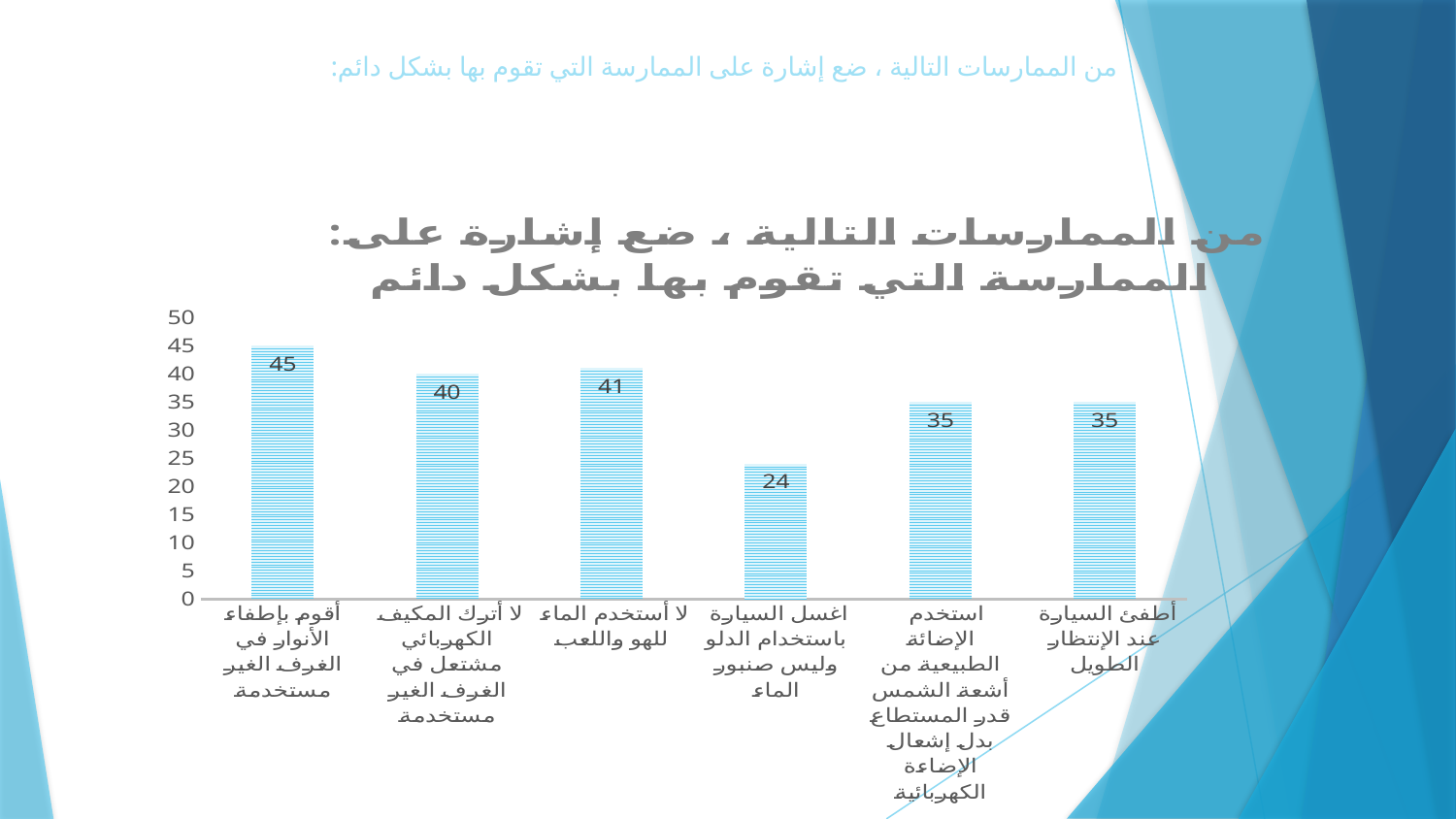
How many categories (practices) are plotted in the chart? 6 Which practice has the highest value in the chart? أقوم بإطفاء الأنوار في الغرف الغير مستخدمة What is the value for "أطفئ السيارة عند الإنتظار الطويل"? 35 Is the value for "اغسل السيارة باستخدام الدلو وليس صنبور الماء" greater or less than 30? less What is the value for "أقوم بإطفاء الأنوار في الغرف الغير مستخدمة"? 45 What is the value for "لا أستخدم الماء للهو واللعب"? 41 What type of chart is shown on the slide? bar chart Which is larger: the value for "لا أترك المكيف الكهربائي مشتعل في الغرف الغير مستخدمة" or the value for "أطفئ السيارة عند الإنتظار الطويل"? لا أترك المكيف الكهربائي مشتعل في الغرف الغير مستخدمة What is the difference between the value for "أقوم بإطفاء الأنوار في الغرف الغير مستخدمة" and the value for "اغسل السيارة باستخدام الدلو وليس صنبور الماء"? 21 What is the title of the chart? من الممارسات التالية ، ضع إشارة على الممارسة التي تقوم بها بشكل دائم What is the value for "اغسل السيارة باستخدام الدلو وليس صنبور الماء"? 24 Which practice has the lowest value in the chart? اغسل السيارة باستخدام الدلو وليس صنبور الماء